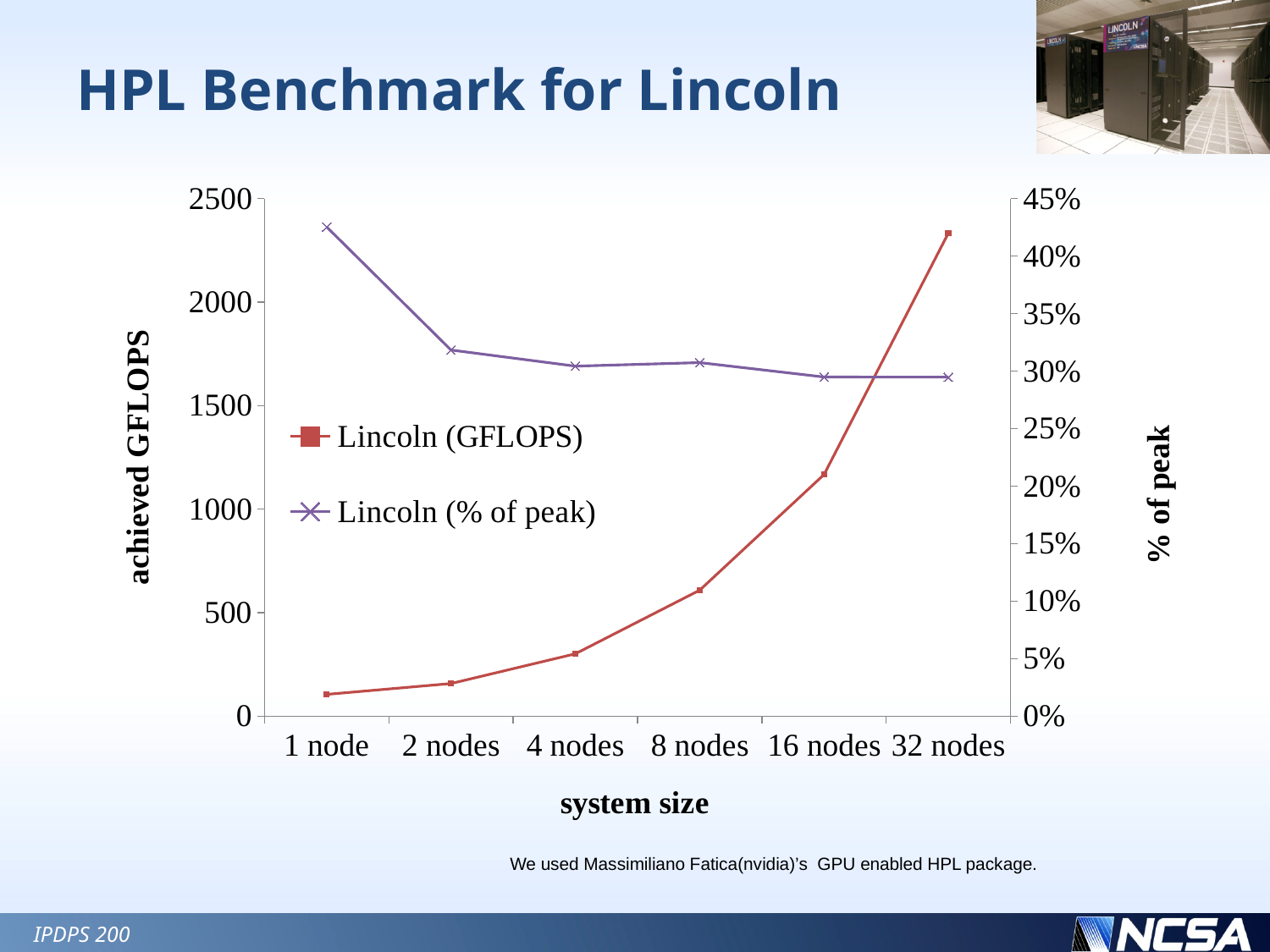
How many system sizes are plotted along the x axis? 6 Is the Lincoln (GFLOPS) value for 32 nodes greater or less than 2000? greater How many series does the legend list? 2 Does Lincoln (GFLOPS) rise or fall as the system size increases from 1 node to 32 nodes? rise Is the Lincoln (GFLOPS) value for 16 nodes greater or less than 1000? greater Is the Lincoln (% of peak) value for 2 nodes greater or less than 35%? less What kind of chart is shown on the slide? line chart At which system size is Lincoln (GFLOPS) lowest? 1 node What is the title of the left vertical axis? achieved GFLOPS At which system size is Lincoln (% of peak) highest? 1 node At which system size is Lincoln (GFLOPS) highest? 32 nodes